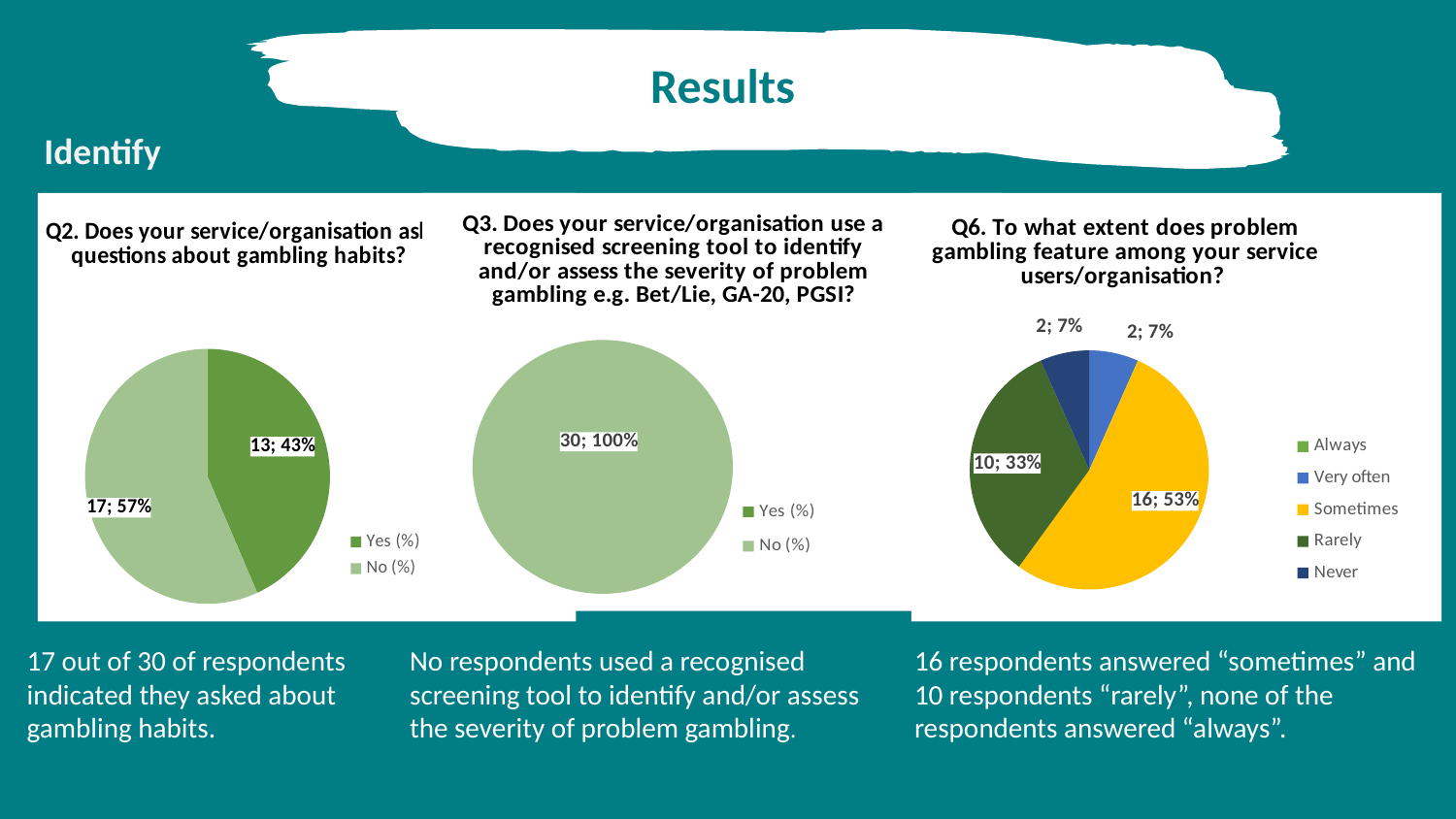
In the Q2 chart (left), what is the data label for the 'No (%)' slice? 17; 57% In the Q2 chart (left), what is the data label for the 'Yes (%)' slice? 13; 43% In the Q6 chart (right), what is the difference in count between the Sometimes and Rarely slices? 6 In the Q3 chart (middle), what is the data label shown on the pie? 30; 100% In the Q6 chart (right), what is the data label for the 'Sometimes' slice? 16; 53% In the Q2 chart (left), what is the difference in count between the No and Yes slices? 4 In the Q6 chart (right), which category has the largest slice? Sometimes In the Q6 chart (right), what is the data label for the 'Rarely' slice? 10; 33% In the Q2 chart (left), which category has the larger share, Yes or No? No What type of chart is used for Q2, Q3 and Q6 on this slide? Pie chart In the Q6 chart (right), how many entries does the legend list? 5 In the Q3 chart (middle), what share of the pie does the 'No (%)' slice take? 100%